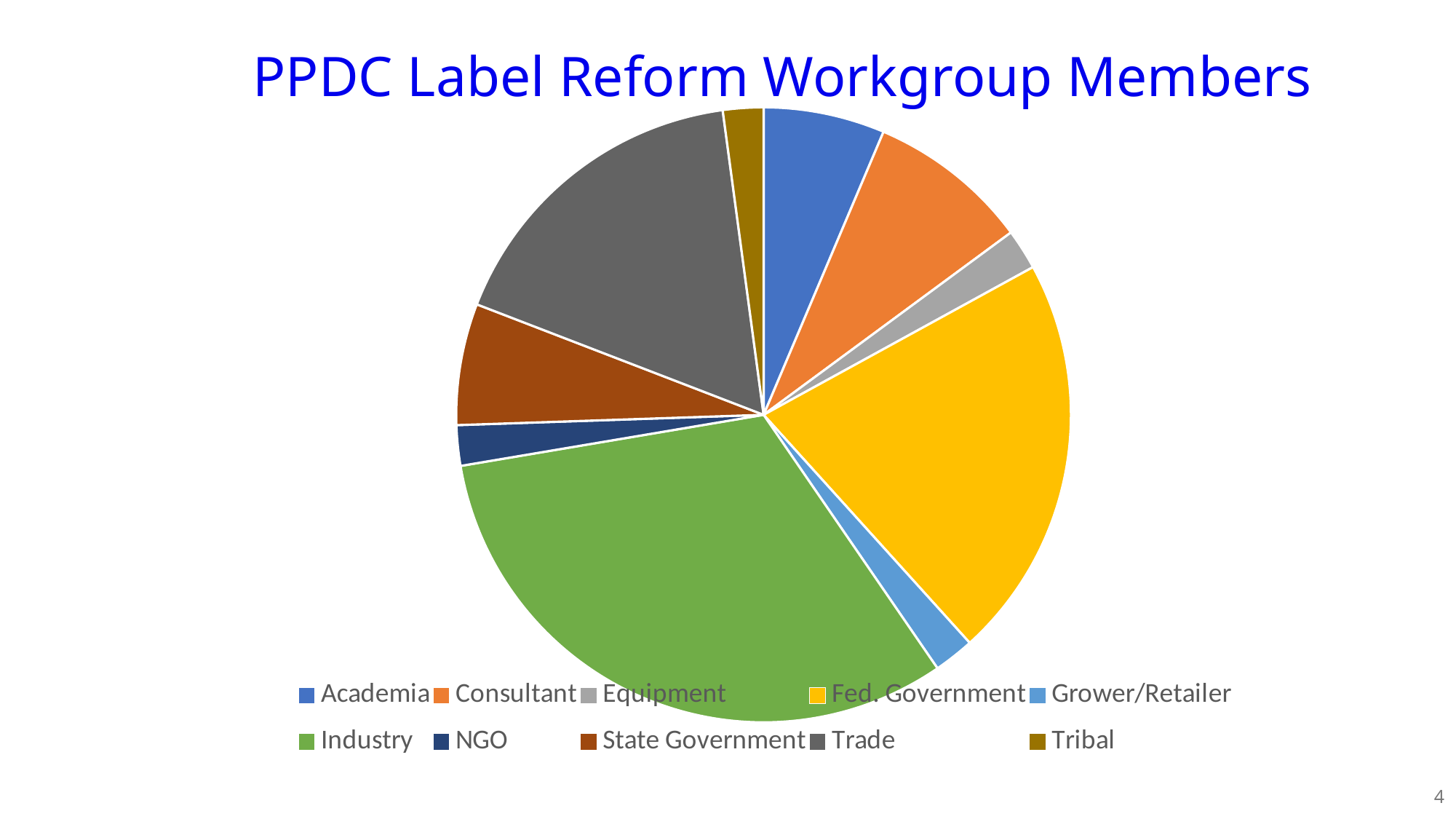
Which slice is larger, State Government or NGO? State Government Which slice is larger, Fed. Government or Grower/Retailer? Fed. Government What colour is the Industry slice in the pie chart? green Which slice is larger, Trade or Academia? Trade How many categories does the pie chart show? 10 Which category has the largest slice of the pie? Industry What is the title of the chart? PPDC Label Reform Workgroup Members What kind of chart is shown on the slide? pie chart